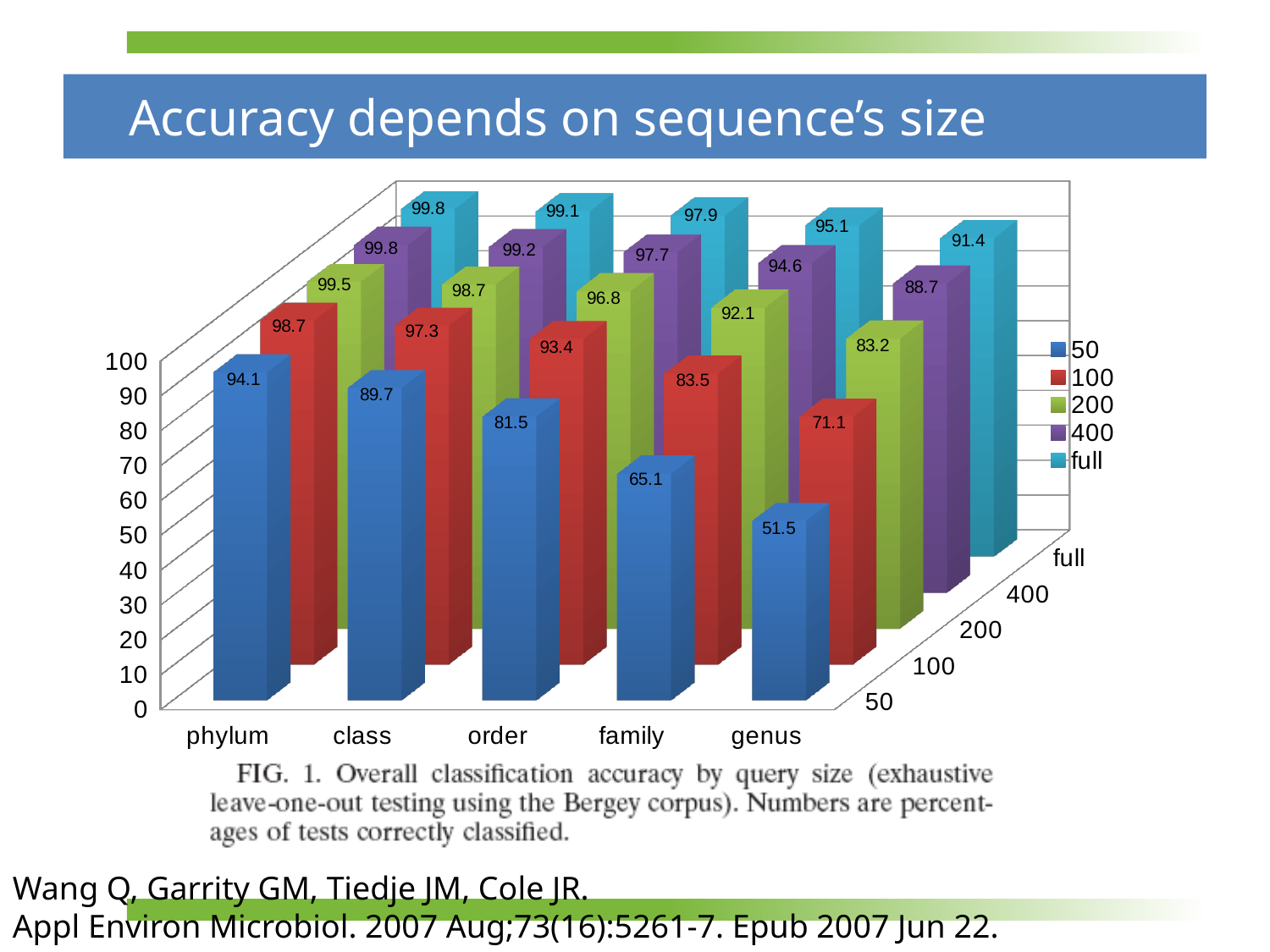
What is the value for order in the full series? 97.9 Do the values in the 100 series rise or fall from phylum to genus? fall Which category has the lowest value in the 50 series? genus How many series does the legend list? 5 Which is larger: the genus value in the 400 series or the genus value in the full series? full What is the value for class in the 400 series? 99.2 Which category has the highest value in the 200 series? phylum What kind of chart is shown on the slide? bar chart How many categories are shown on the x axis? 5 What is the value for genus in the 50 series? 51.5 What is the value for family in the 100 series? 83.5 What is the difference between the phylum and genus values in the 50 series? 42.6